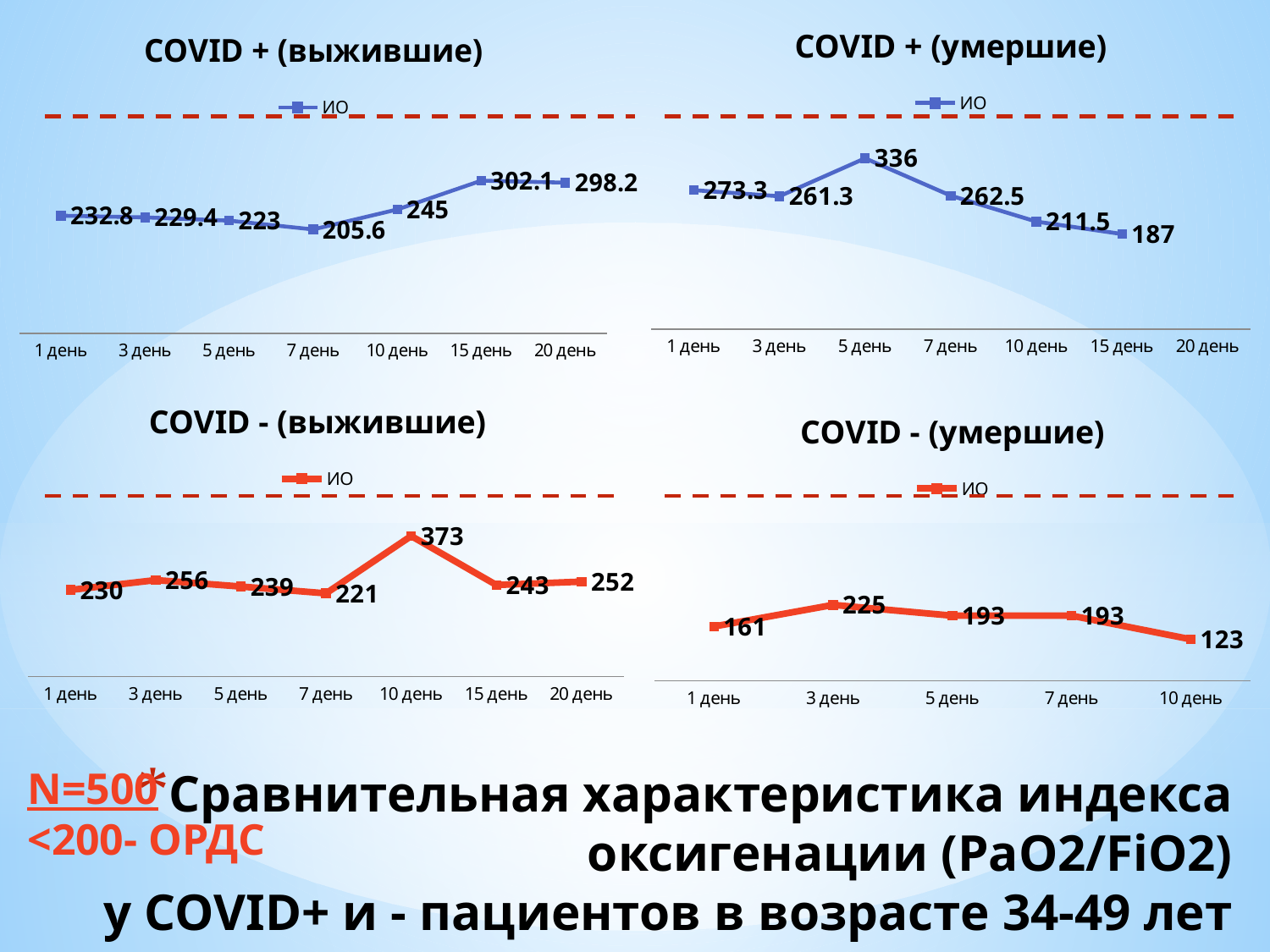
In the chart titled "COVID - (выжившие)", which is larger, the value on 3 день or the value on 7 день? 3 день In the chart titled "COVID + (умершие)", what is the value on 1 день? 273.3 In the chart titled "COVID + (умершие)", what is the lowest value shown? 187 In the chart titled "COVID - (выжившие)", what is the value on 10 день? 373 In the chart titled "COVID + (выжившие)", what is the difference between the values on 15 день and 1 день? 69.3 In the chart titled "COVID - (умершие)", what is the value on 10 день? 123 What kind of chart is the chart titled "COVID - (выжившие)"? Line chart In the chart titled "COVID + (выжившие)", what is the value on 7 день? 205.6 In the chart titled "COVID - (умершие)", what is the difference between the values on 3 день and 1 день? 64 In the chart titled "COVID - (умершие)", how many days are shown on the x axis? 5 In the chart titled "COVID + (умершие)", what is the highest value shown? 336 In the chart titled "COVID + (выжившие)", which day has the highest value? 15 день